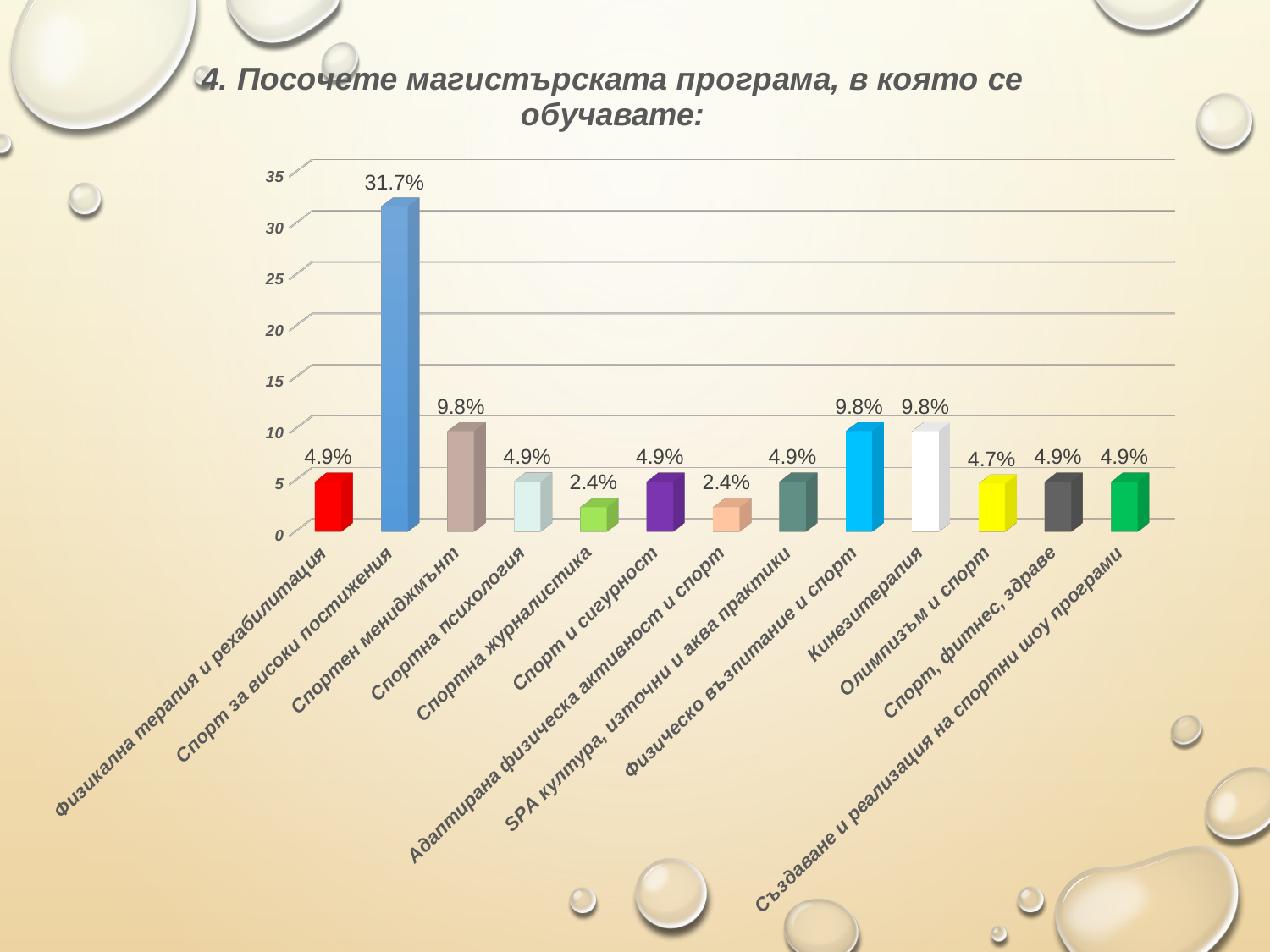
What value is shown for Спортен мениджмънт? 9.8% Is the value for Спорт за високи постижения greater or less than 30? greater What kind of chart is shown on the slide? Bar chart What is the difference between the values for Спорт за високи постижения and Физическо възпитание и спорт? 21.9% What value is shown for Спортна журналистика? 2.4% What value is shown for Спорт за високи постижения? 31.7% Which category has the highest value? Спорт за високи постижения What is the difference between the values for Спортен мениджмънт and Адаптирана физическа активност и спорт? 7.4% What value is shown for Кинезитерапия? 9.8% How many categories are shown on the x axis? 13 What value is shown for Олимпизъм и спорт? 4.7% Which is larger, the value for Спорт и сигурност or the value for Спортна журналистика? Спорт и сигурност